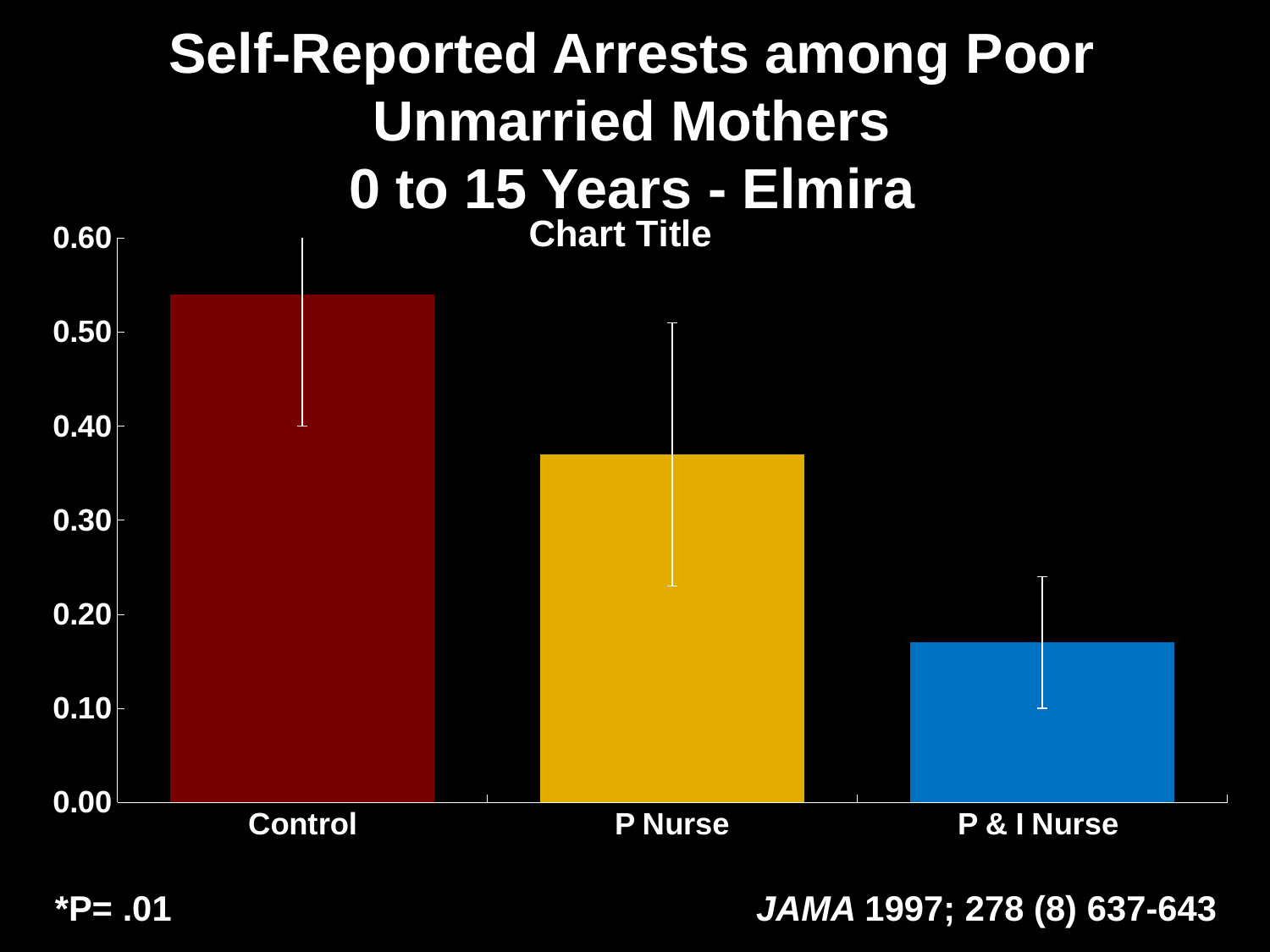
How many categories are shown on the x axis of the chart? 3 Is the value for P Nurse greater or less than 0.30? greater Is the value for Control greater or less than 0.50? greater Which has a larger value, P Nurse or P & I Nurse? P Nurse Which category has the highest value in the chart? Control Is the value for P Nurse greater or less than 0.40? less Which has a larger value, Control or P Nurse? Control What kind of chart is shown on the slide? bar chart Do the bar values rise or fall moving from left to right across the x axis? fall Which category has the lowest value in the chart? P & I Nurse What is the highest value shown on the y axis of the chart? 0.60